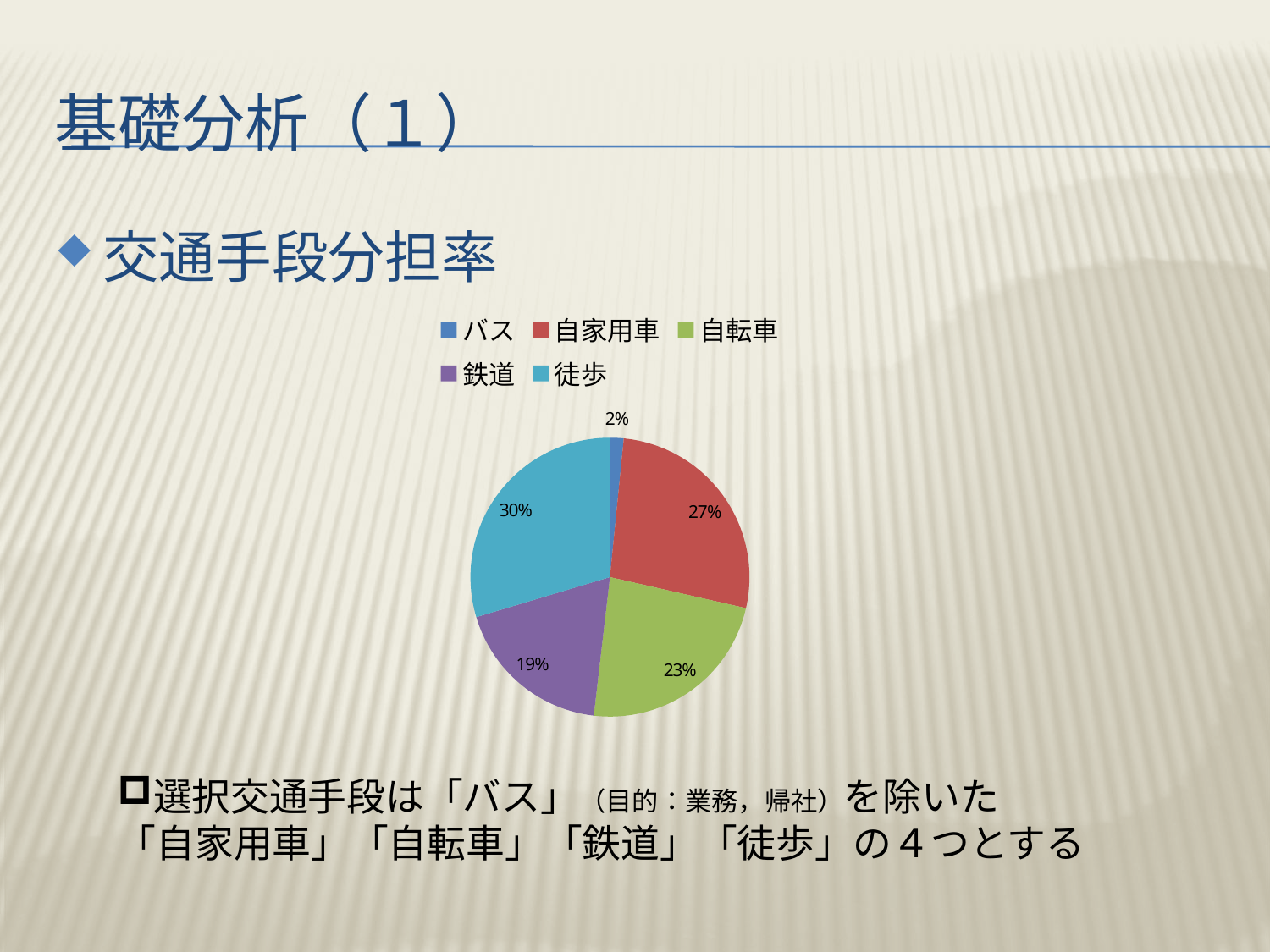
Which has a larger share, 自家用車 or 自転車? 自家用車 What kind of chart is shown on the slide? pie chart What share of the pie does 鉄道 (rail) have? 19% What is the difference in percentage points between 徒歩 and 鉄道? 11 What share of the pie does 徒歩 (walking) have? 30% Which transport mode has the smallest share in the pie chart? バス What share of the pie does 自転車 (bicycle) have? 23% How many categories does the pie chart have? 5 What colour is the 鉄道 slice in the pie chart? purple Which transport mode has the largest share in the pie chart? 徒歩